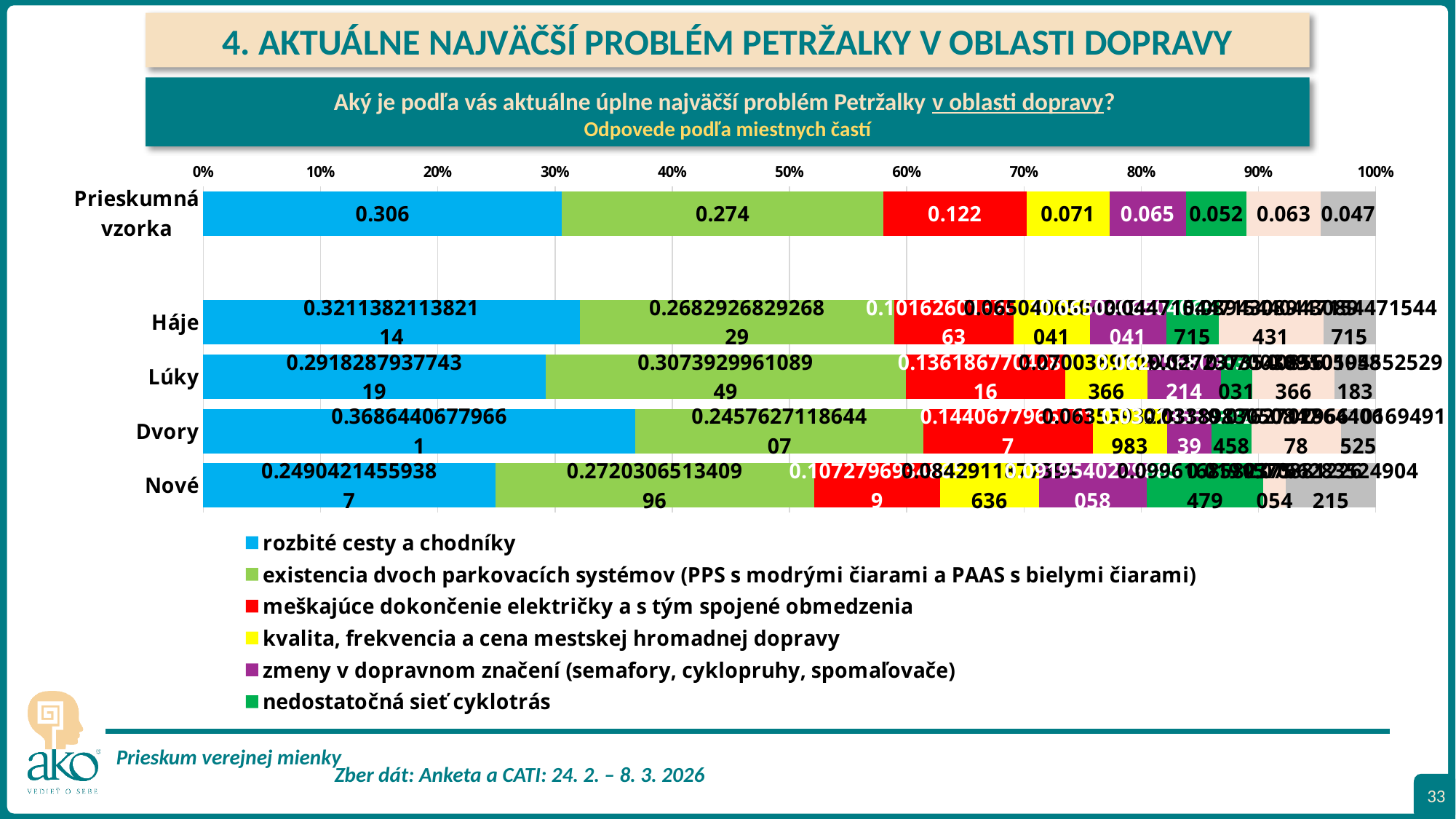
Which district has the lowest value for 'rozbité cesty a chodníky'? Nové What is the value for 'meškajúce dokončenie električky a s tým spojené obmedzenia' in the 'Prieskumná vzorka' bar? 0.122 Is the value for 'rozbité cesty a chodníky' in the 'Dvory' bar greater or less than 30%? greater What is the value for 'rozbité cesty a chodníky' in the 'Prieskumná vzorka' bar? 0.306 What is the value for 'kvalita, frekvencia a cena mestskej hromadnej dopravy' in the 'Prieskumná vzorka' bar? 0.071 How many bars (rows) are shown in the chart? 5 Which is larger for 'rozbité cesty a chodníky': Dvory or Háje? Dvory In the 'Lúky' bar, which is larger: 'rozbité cesty a chodníky' or 'existencia dvoch parkovacích systémov'? existencia dvoch parkovacích systémov Which district has the highest value for 'rozbité cesty a chodníky'? Dvory What is the value for 'existencia dvoch parkovacích systémov' in the 'Prieskumná vzorka' bar? 0.274 How many series does the legend list? 6 In the 'Prieskumná vzorka' bar, what is the difference between the values for 'rozbité cesty a chodníky' and 'existencia dvoch parkovacích systémov'? 0.032